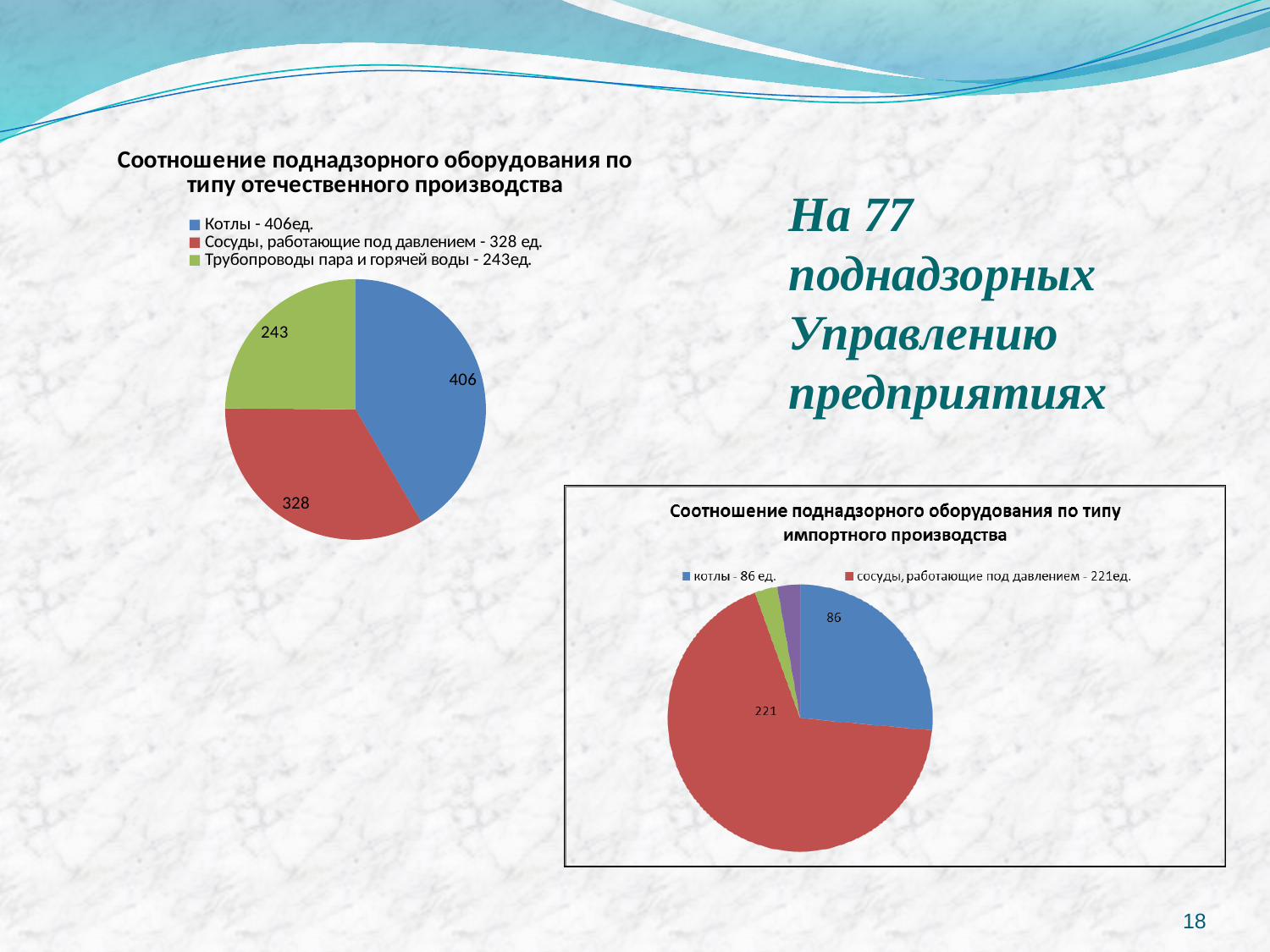
On the chart titled "Соотношение поднадзорного оборудования по типу отечественного производства", what is the difference between the values for Котлы and Сосуды, работающие под давлением? 78 On the chart titled "Соотношение поднадзорного оборудования по типу отечественного производства", what colour is the slice for Сосуды, работающие под давлением? Red On the chart titled "Соотношение поднадзорного оборудования по типу импортного производства", which is larger, котлы or сосуды, работающие под давлением? сосуды, работающие под давлением On the chart titled "Соотношение поднадзорного оборудования по типу импортного производства", what is the value for котлы? 86 On the chart titled "Соотношение поднадзорного оборудования по типу отечественного производства", what is the value for Трубопроводы пара и горячей воды? 243 On the chart titled "Соотношение поднадзорного оборудования по типу отечественного производства", what is the value for Котлы? 406 On the chart titled "Соотношение поднадзорного оборудования по типу отечественного производства", how many categories does the legend list? 3 What kind of chart is the chart titled "Соотношение поднадзорного оборудования по типу отечественного производства"? Pie chart On the chart titled "Соотношение поднадзорного оборудования по типу отечественного производства", which category has the smallest slice? Трубопроводы пара и горячей воды On the chart titled "Соотношение поднадзорного оборудования по типу отечественного производства", which category has the largest slice? Котлы On the chart titled "Соотношение поднадзорного оборудования по типу импортного производства", what is the value for сосуды, работающие под давлением? 221 On the chart titled "Соотношение поднадзорного оборудования по типу импортного производства", what is the difference between the values for сосуды, работающие под давлением and котлы? 135